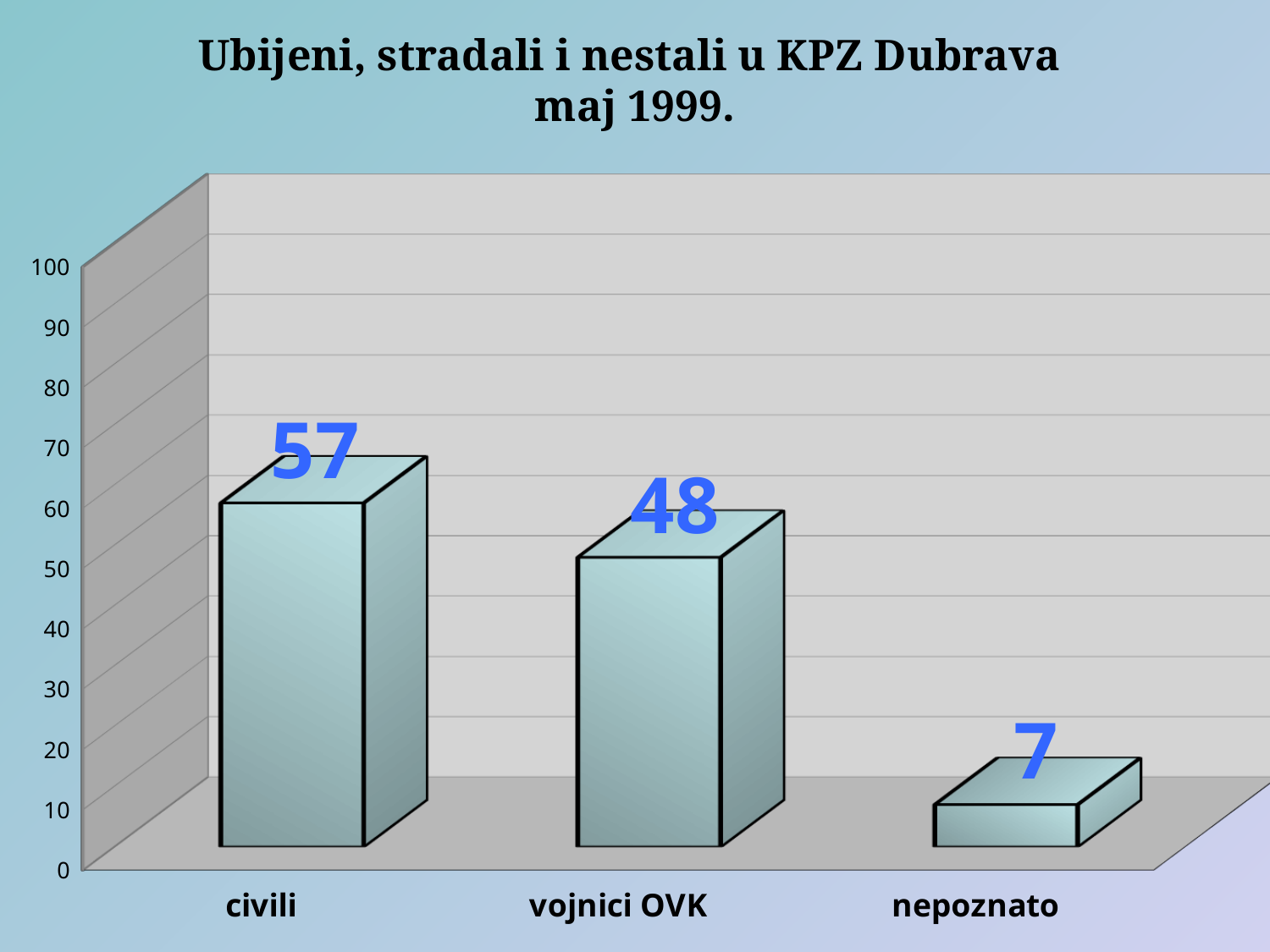
What is the title of the chart? Ubijeni, stradali i nestali u KPZ Dubrava maj 1999. What is the difference between the values for vojnici OVK and nepoznato? 41 Which is larger, the value for civili or the value for vojnici OVK? civili Which category has the highest value? civili What is the value for civili? 57 What is the difference between the values for civili and vojnici OVK? 9 What is the value for nepoznato? 7 Which category has the lowest value? nepoznato What kind of chart is shown on the slide? bar chart How many categories are shown on the chart? 3 What is the value for vojnici OVK? 48 Is the value for vojnici OVK greater or less than 50? less